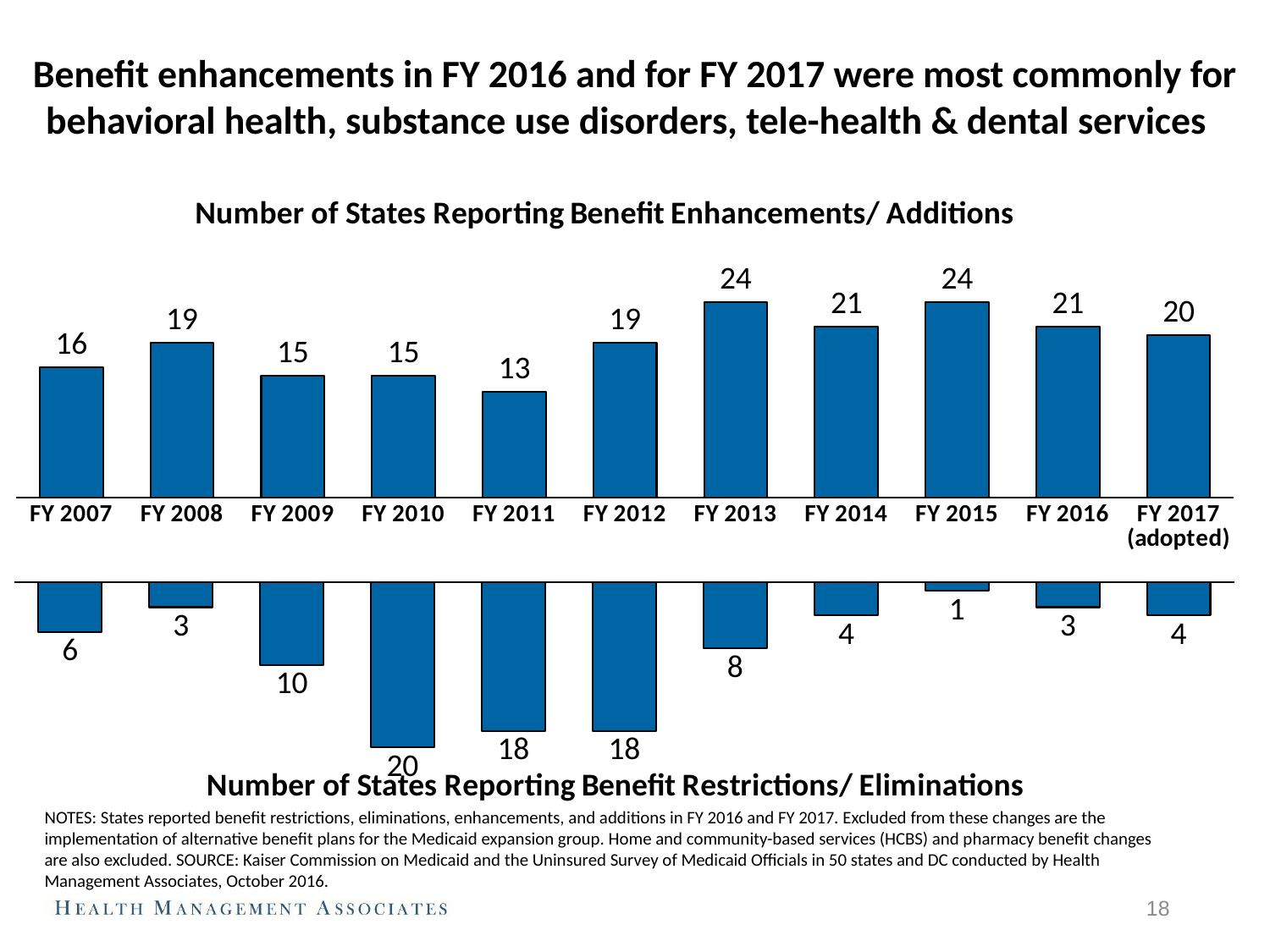
In the 'Number of States Reporting Benefit Restrictions/ Eliminations' chart, what is the value for FY 2010? 20 How many fiscal years are shown in the 'Number of States Reporting Benefit Enhancements/ Additions' chart? 11 In the 'Number of States Reporting Benefit Enhancements/ Additions' chart, what is the value for FY 2017 (adopted)? 20 In the 'Number of States Reporting Benefit Restrictions/ Eliminations' chart, which fiscal year has the lowest value? FY 2015 In the 'Number of States Reporting Benefit Enhancements/ Additions' chart, which is larger, the value for FY 2008 or the value for FY 2009? FY 2008 What type of chart is the 'Number of States Reporting Benefit Restrictions/ Eliminations' chart? Bar chart In the 'Number of States Reporting Benefit Restrictions/ Eliminations' chart, what is the difference between the FY 2009 value and the FY 2008 value? 7 In the 'Number of States Reporting Benefit Enhancements/ Additions' chart, which fiscal year has the lowest value? FY 2011 In the 'Number of States Reporting Benefit Enhancements/ Additions' chart, how many states reported benefit enhancements in FY 2011? 13 In the 'Number of States Reporting Benefit Restrictions/ Eliminations' chart, what is the value for FY 2015? 1 In the 'Number of States Reporting Benefit Restrictions/ Eliminations' chart, which fiscal year has the highest value? FY 2010 In the 'Number of States Reporting Benefit Enhancements/ Additions' chart, what is the difference between the FY 2013 value and the FY 2011 value? 11